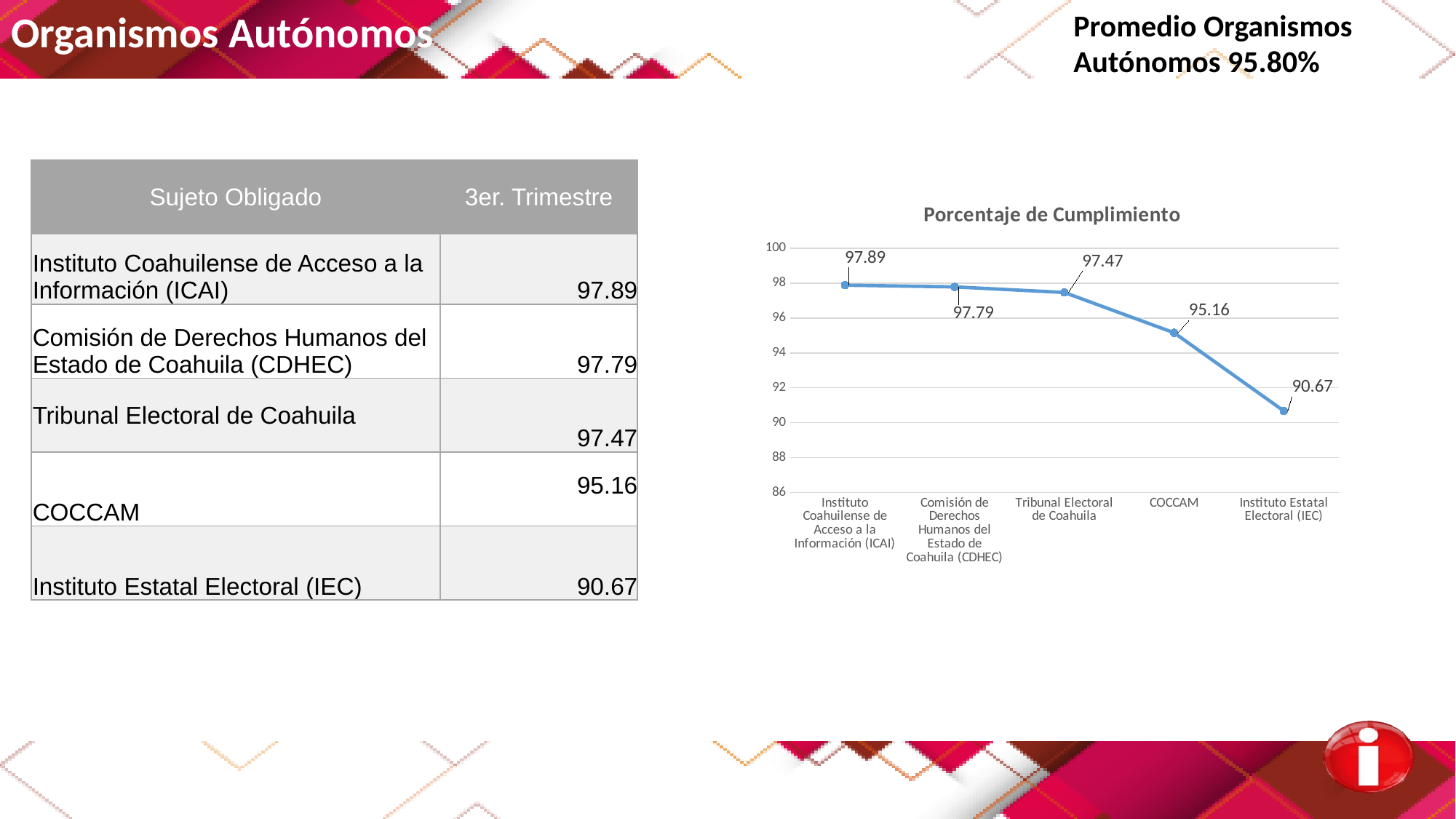
What kind of chart is shown on the slide? line chart What is the value for COCCAM in the Porcentaje de Cumplimiento chart? 95.16 Which is larger: the value for Tribunal Electoral de Coahuila or the value for COCCAM? Tribunal Electoral de Coahuila What is the value for Tribunal Electoral de Coahuila in the chart? 97.47 Which category has the lowest value in the chart? Instituto Estatal Electoral (IEC) Which category has the highest value in the Porcentaje de Cumplimiento chart? Instituto Coahuilense de Acceso a la Información (ICAI) What is the title of the chart? Porcentaje de Cumplimiento Is the value for Instituto Estatal Electoral (IEC) greater or less than 92? less What is the difference between the values for COCCAM and Instituto Estatal Electoral (IEC)? 4.49 How many categories are plotted in the Porcentaje de Cumplimiento chart? 5 Do the values rise or fall from left to right along the x axis? fall What is the value for Instituto Estatal Electoral (IEC) in the chart? 90.67